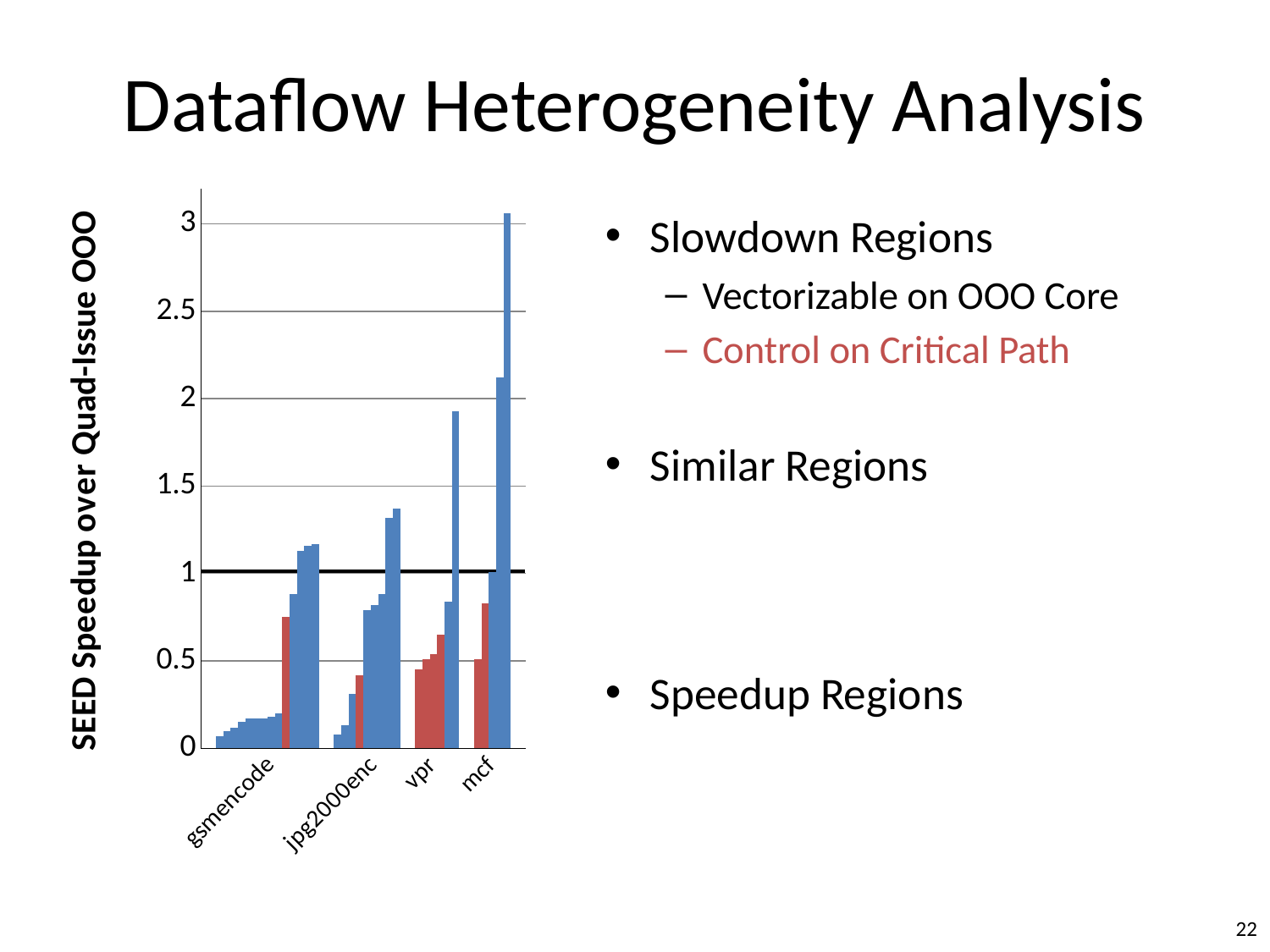
How many benchmark categories are labelled on the x axis of the chart? 4 Is the tallest bar for vpr greater or less than 1.5? greater At what y-axis value is the thick horizontal reference line drawn in the chart? 1 Which benchmark category contains the tallest bar in the chart? mcf Is the tallest bar for gsmencode greater or less than 1.5? less What kind of chart is shown on the slide? bar chart What is the highest tick value shown on the y axis of the chart? 3 Is the tallest bar for jpg2000enc greater or less than 1? greater What is the label of the y axis of the chart? SEED Speedup over Quad-Issue OOO Is the tallest bar for vpr larger than the tallest bar for jpg2000enc? yes